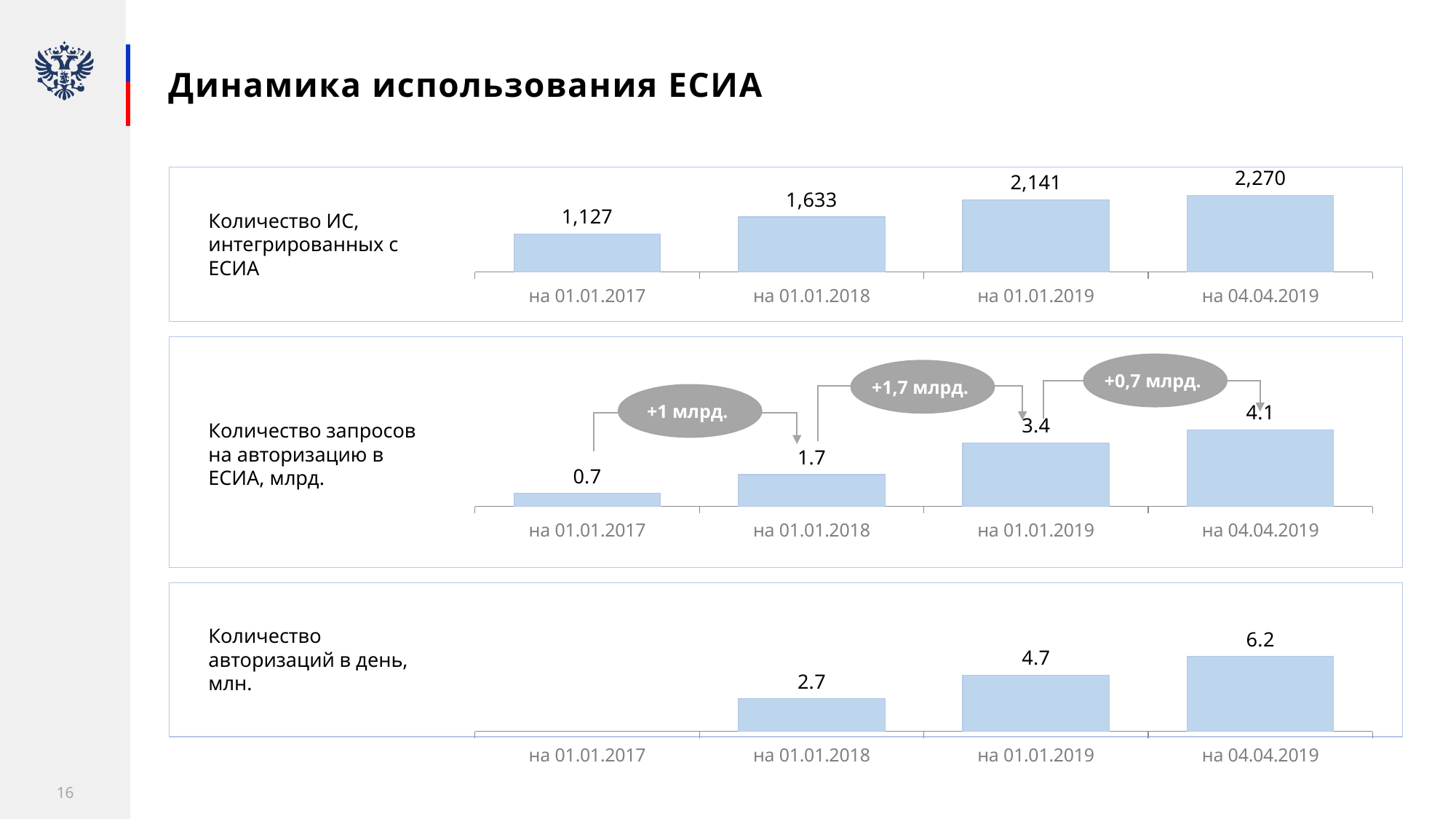
In the top chart (Количество ИС, интегрированных с ЕСИА), what is the difference between the values for на 01.01.2019 and на 01.01.2018? 508 In the bottom chart (Количество авторизаций в день, млн.), which is larger: the value for на 01.01.2018 or на 01.01.2019? на 01.01.2019 In the bottom chart (Количество авторизаций в день, млн.), what is the difference between the values for на 04.04.2019 and на 01.01.2019? 1.5 What kind of chart is the middle chart (Количество запросов на авторизацию в ЕСИА, млрд.)? bar chart In the top chart (Количество ИС, интегрированных с ЕСИА), which category has the highest value? на 04.04.2019 In the middle chart (Количество запросов на авторизацию в ЕСИА, млрд.), what is the value for на 01.01.2019? 3.4 In the bottom chart (Количество авторизаций в день, млн.), what is the value for на 04.04.2019? 6.2 In the middle chart (Количество запросов на авторизацию в ЕСИА, млрд.), what increase is shown in the callout between на 01.01.2018 and на 01.01.2019? +1,7 млрд. In the middle chart (Количество запросов на авторизацию в ЕСИА, млрд.), which category has the lowest value? на 01.01.2017 In the middle chart (Количество запросов на авторизацию в ЕСИА, млрд.), do the values rise or fall from left to right along the x axis? rise In the top chart (Количество ИС, интегрированных с ЕСИА), what is the value for на 01.01.2018? 1,633 How many categories are shown on the x axis of the top chart (Количество ИС, интегрированных с ЕСИА)? 4